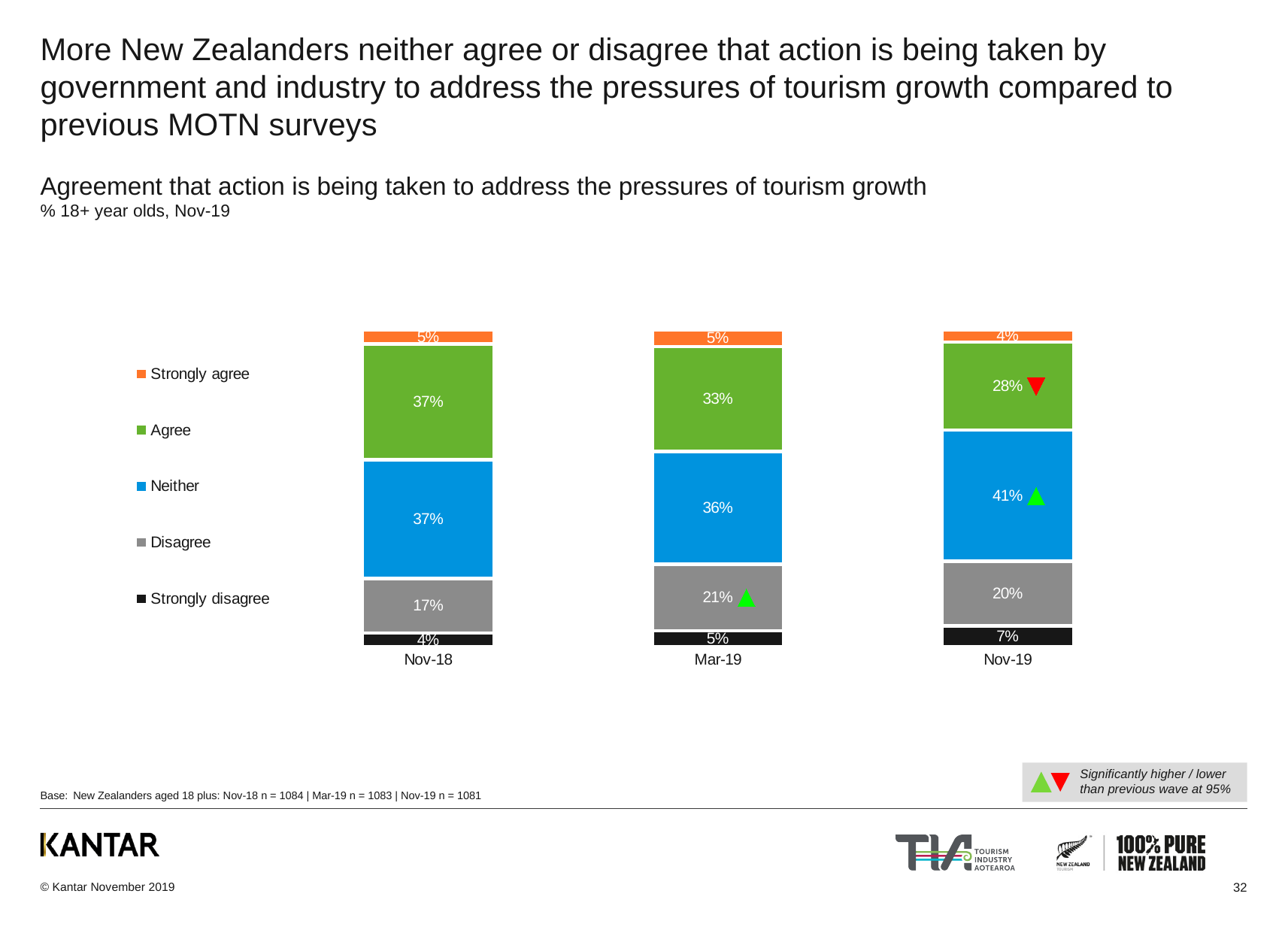
What is the 'Strongly disagree' value for Nov-18? 4% What is the 'Disagree' value for Mar-19? 21% What percentage of respondents answered 'Neither' in Nov-19? 41% What kind of chart is shown on the slide? Stacked bar chart What is the difference between the 'Agree' values for Nov-18 and Nov-19? 9 percentage points Does the 'Strongly disagree' share rise or fall from Nov-18 to Nov-19? Rise In which survey wave is the 'Neither' share highest? Nov-19 In which survey wave is the 'Agree' share lowest? Nov-19 What is the 'Agree' value for Mar-19? 33% How many survey waves are shown on the x axis? 3 Which is larger in Nov-19: the 'Agree' share or the 'Neither' share? Neither How many series does the legend list? 5